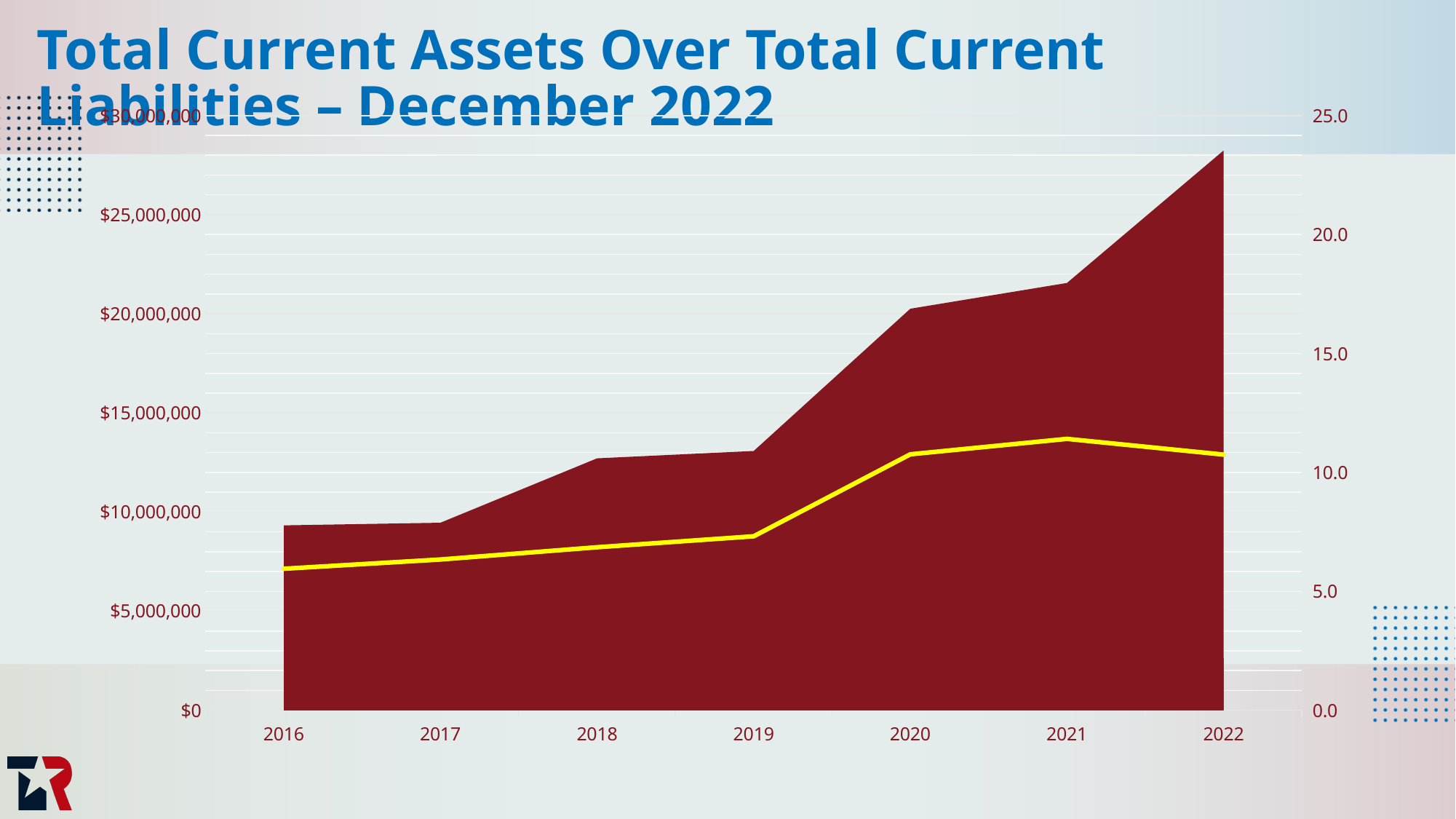
What is the title of the chart on the slide? Total Current Assets Over Total Current Liabilities – December 2022 How many years are shown along the x axis of the chart? 7 Is the value of the dark red area series for 2019 greater or less than $15,000,000? less Is the value of the dark red area series for 2016 greater or less than $10,000,000? less On the right-hand axis, is the value of the yellow line for 2021 greater or less than 10.0? greater Which year has the highest value for the dark red area series? 2022 What is the highest tick label shown on the right-hand axis? 25.0 Which year has the highest value for the yellow line series? 2021 What kind of chart is shown on the slide? Area chart with a line Which year has a larger value for the dark red area series, 2018 or 2020? 2020 Does the dark red area series generally rise or fall from 2016 to 2022? Rise